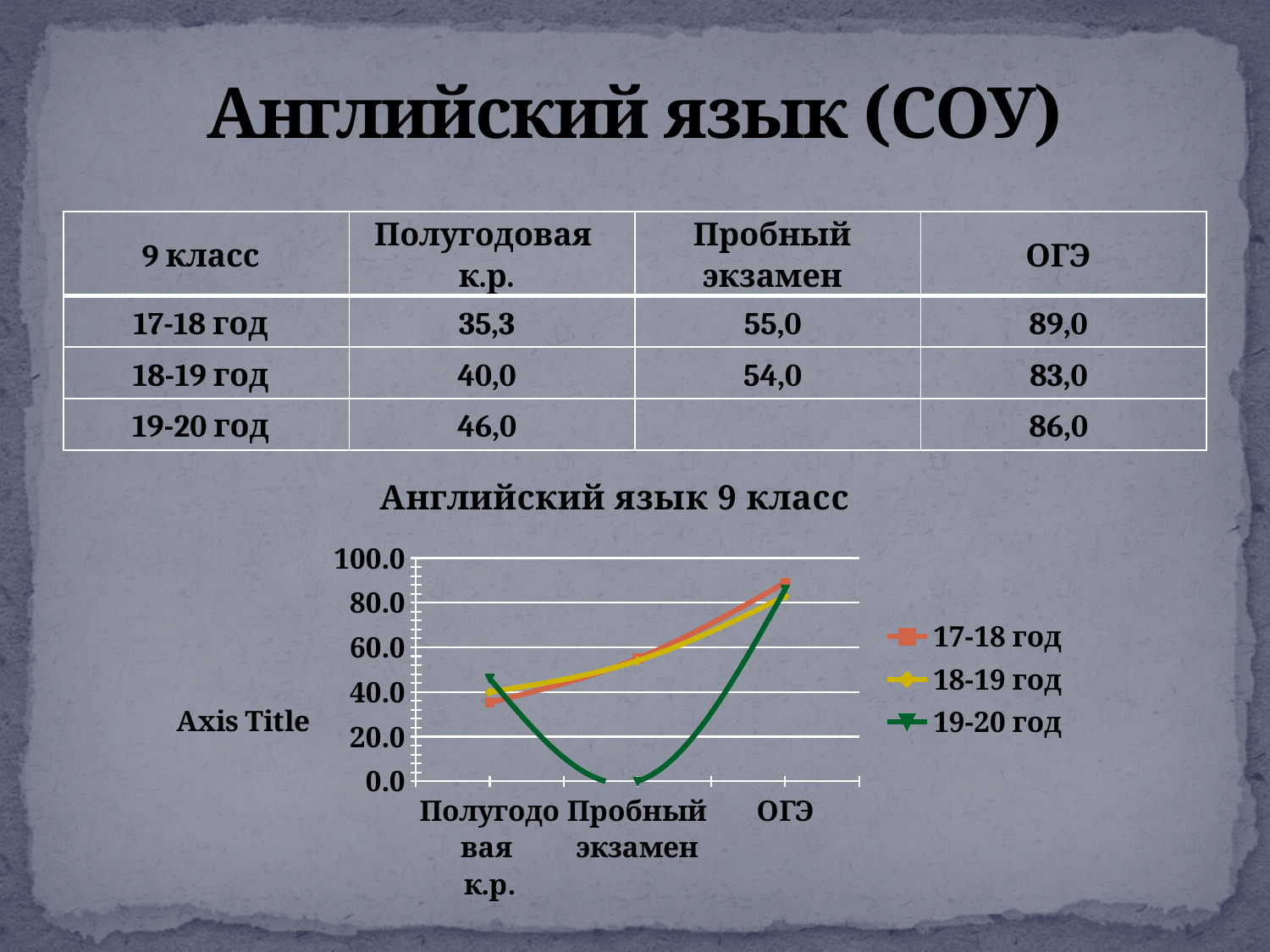
What colour is the line for the '19-20 год' series in the chart 'Английский язык 9 класс'? green In the chart 'Английский язык 9 класс', is the value for '18-19 год' at 'ОГЭ' greater or less than 80? greater In the chart 'Английский язык 9 класс', is the value for '19-20 год' at 'Полугодовая к.р.' greater or less than 40? greater What kind of chart is shown under the title 'Английский язык 9 класс'? line chart How many categories are shown on the x axis of the chart 'Английский язык 9 класс'? 3 In the chart 'Английский язык 9 класс', which category has the highest value for the '17-18 год' series? ОГЭ What is the title of the line chart on the slide? Английский язык 9 класс In the chart 'Английский язык 9 класс', is the value for '17-18 год' at 'Полугодовая к.р.' greater or less than 40? less How many series does the legend of the chart 'Английский язык 9 класс' list? 3 In the chart 'Английский язык 9 класс', which series is higher at 'Полугодовая к.р.': '17-18 год' or '19-20 год'? 19-20 год In the chart 'Английский язык 9 класс', does the '17-18 год' series rise or fall from 'Полугодовая к.р.' to 'ОГЭ'? rise